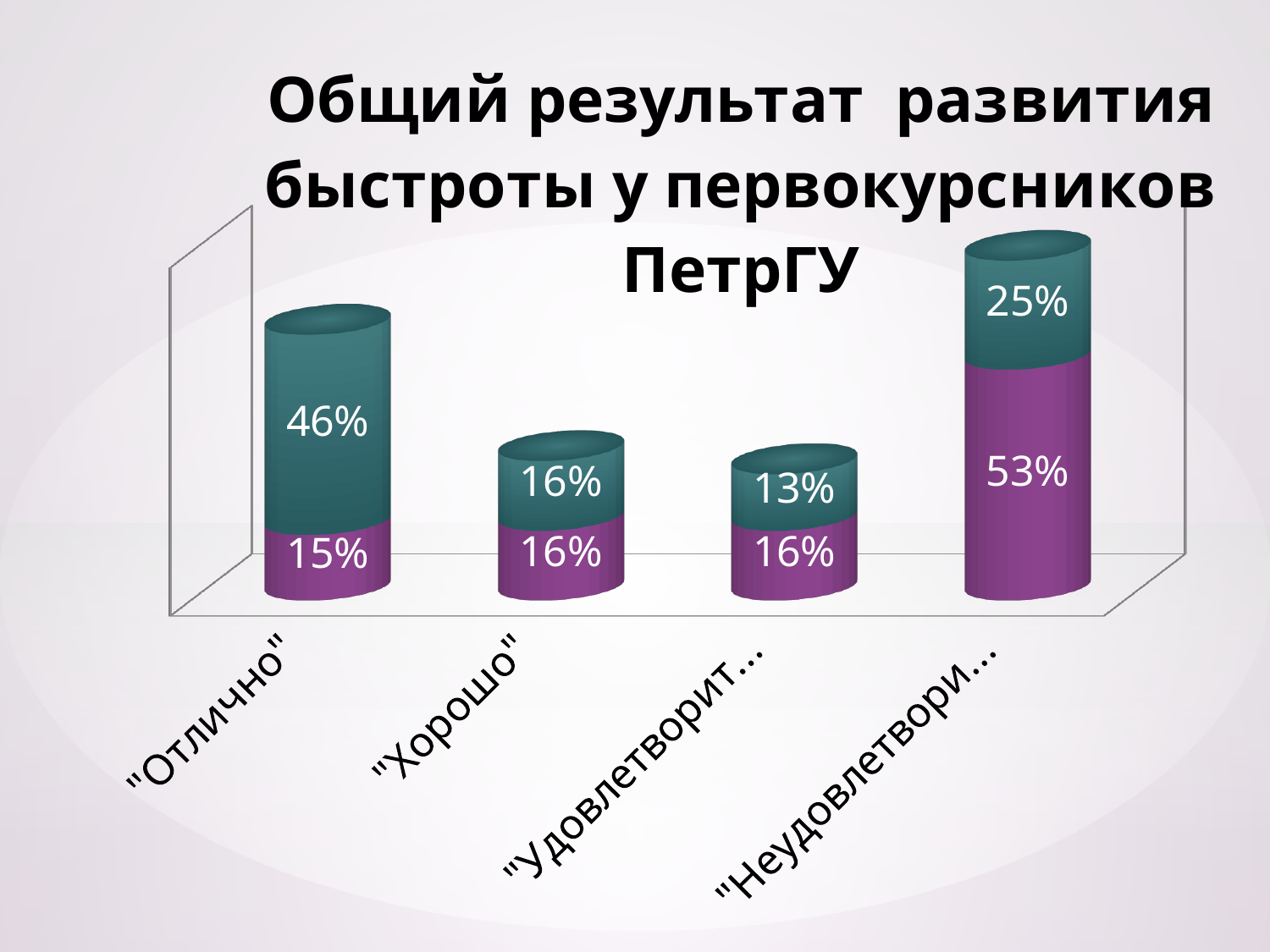
What is the value of the teal (top) segment for the "Отлично" bar? 46% What is the value of the teal (top) segment for the "Хорошо" bar? 16% What is the total of the two stacked segments for the "Отлично" bar? 61% What is the value of the purple (bottom) segment for the "Отлично" bar? 15% Which category has the tallest stacked bar? "Неудовлетвори..." (the rightmost bar) What is the total of the two stacked segments of the rightmost bar ("Неудовлетвори...")? 78% What is the difference between the teal segment of "Отлично" and the teal segment of "Хорошо"? 30 percentage points How many categories are shown on the x axis? 4 What is the value of the purple (bottom) segment of the rightmost bar ("Неудовлетвори...")? 53% How many series are stacked in each bar? 2 What type of chart is shown on the slide? Stacked bar chart What is the total of the two stacked segments for the "Хорошо" bar? 32%